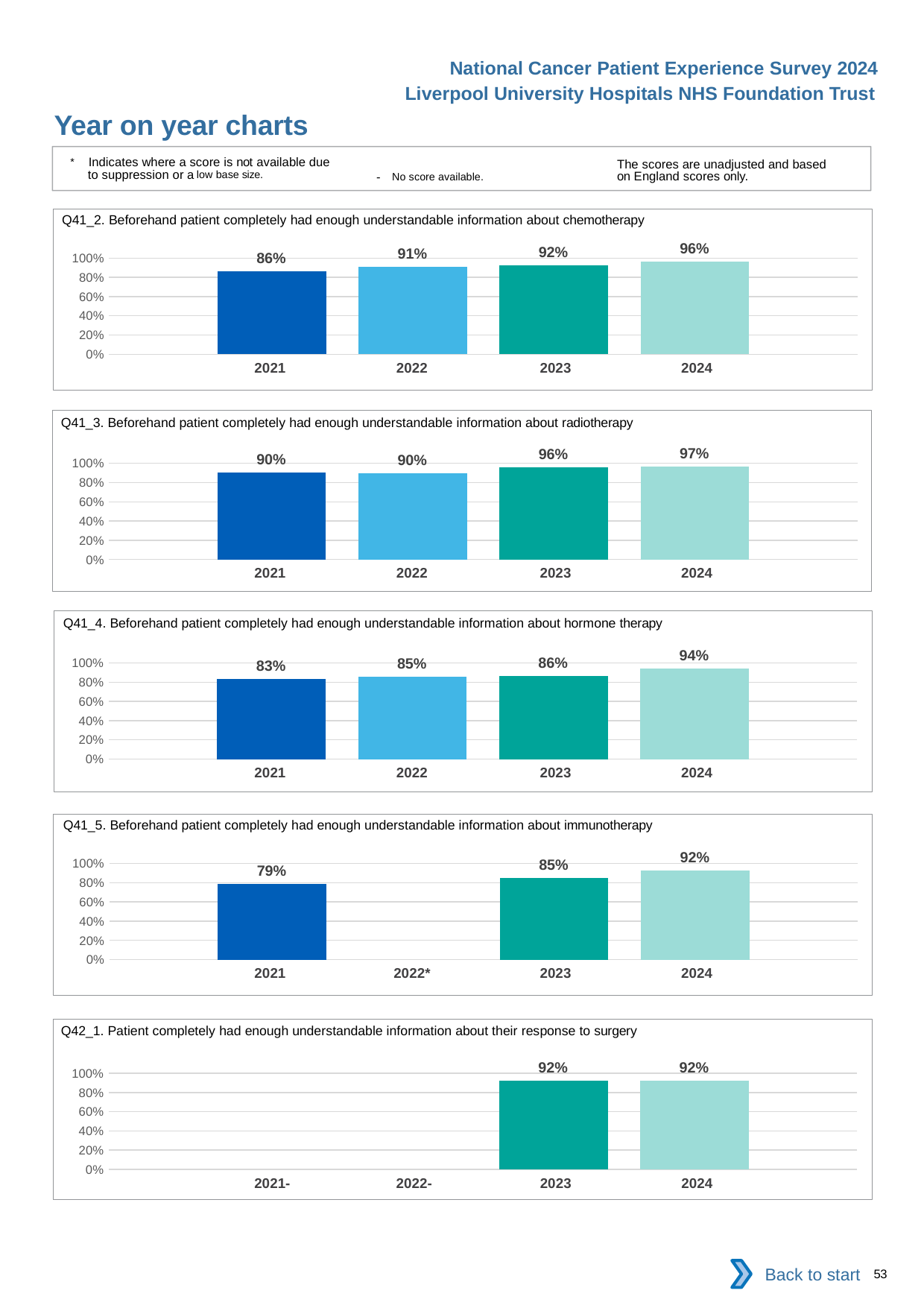
In the Q41_2 chemotherapy chart, which year has the highest value? 2024 In the Q41_3 radiotherapy chart, what is the value for 2024? 97% In the Q41_5 immunotherapy chart, what is the value for 2021? 79% In the Q41_4 hormone therapy chart, which year has the lowest value? 2021 In the Q42_1 response to surgery chart, how many bars are plotted? 2 In the Q41_4 hormone therapy chart, what is the value for 2024? 94% In the Q42_1 response to surgery chart, what is the value for 2023? 92% In the Q41_5 immunotherapy chart, which year has no bar shown? 2022* In the Q41_5 immunotherapy chart, is the value for 2023 greater or less than 80%? greater In the Q41_2 chemotherapy chart, what is the value for 2021? 86% In the Q41_3 radiotherapy chart, what is the difference between the 2023 and 2022 values? 6% What type of chart is the Q41_2 chemotherapy chart? Bar chart